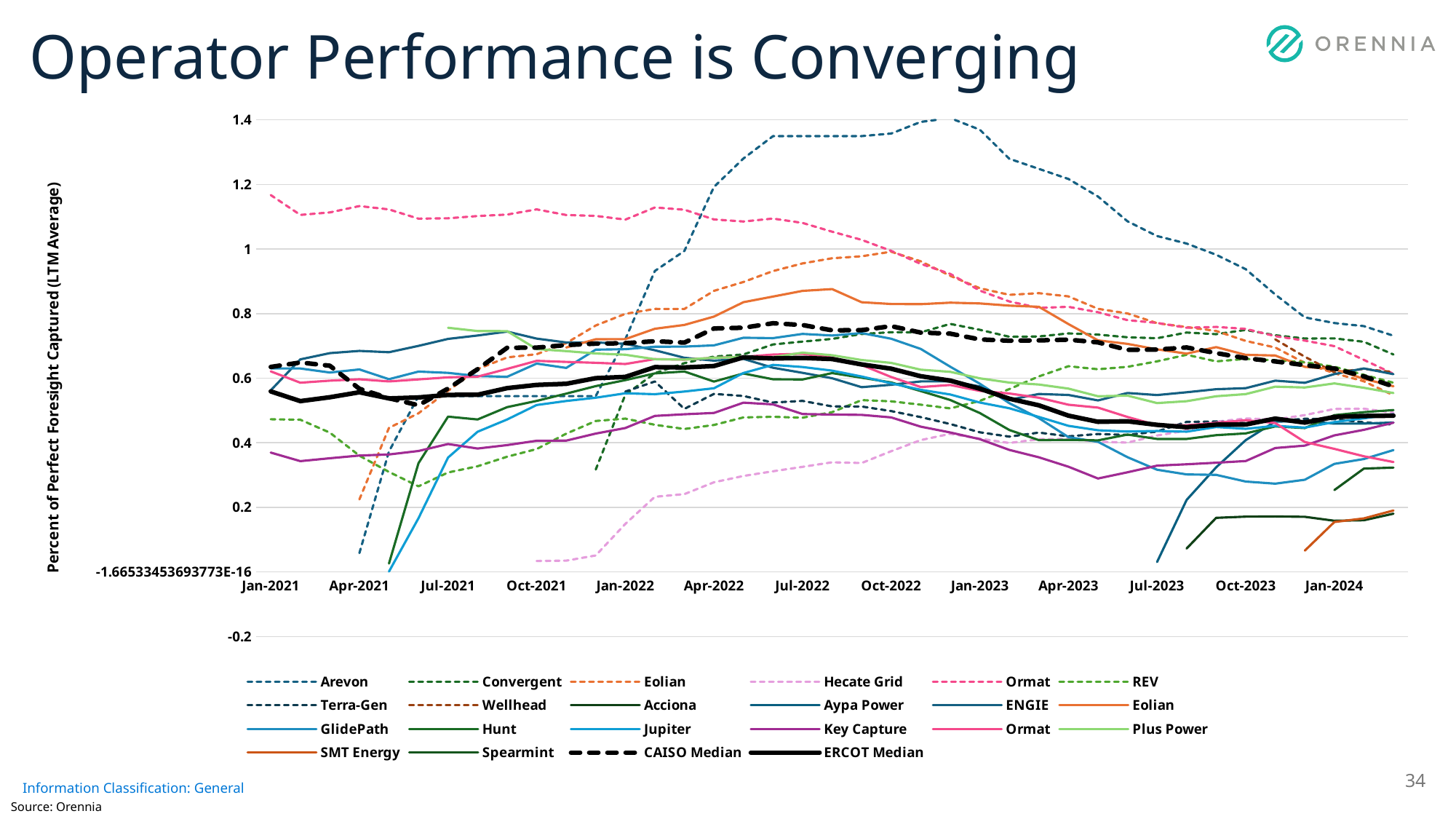
How many date labels are shown on the x axis? 13 What kind of chart is shown on the slide? Line chart Is the value for the dashed Ormat series at Jan-2021 greater or less than 1? greater Which series has the highest value at Jan-2023? Arevon Is the value for Hecate Grid at Jan-2022 greater or less than 0.4? less Is the value for CAISO Median at Jul-2022 greater or less than 0.6? greater What is the label of the vertical axis? Percent of Perfect Foresight Captured (LTM Average) What is the title of the chart on the slide? Operator Performance is Converging Does the Arevon series rise or fall between Jan-2023 and Jan-2024? Fall How many series does the legend list? 22